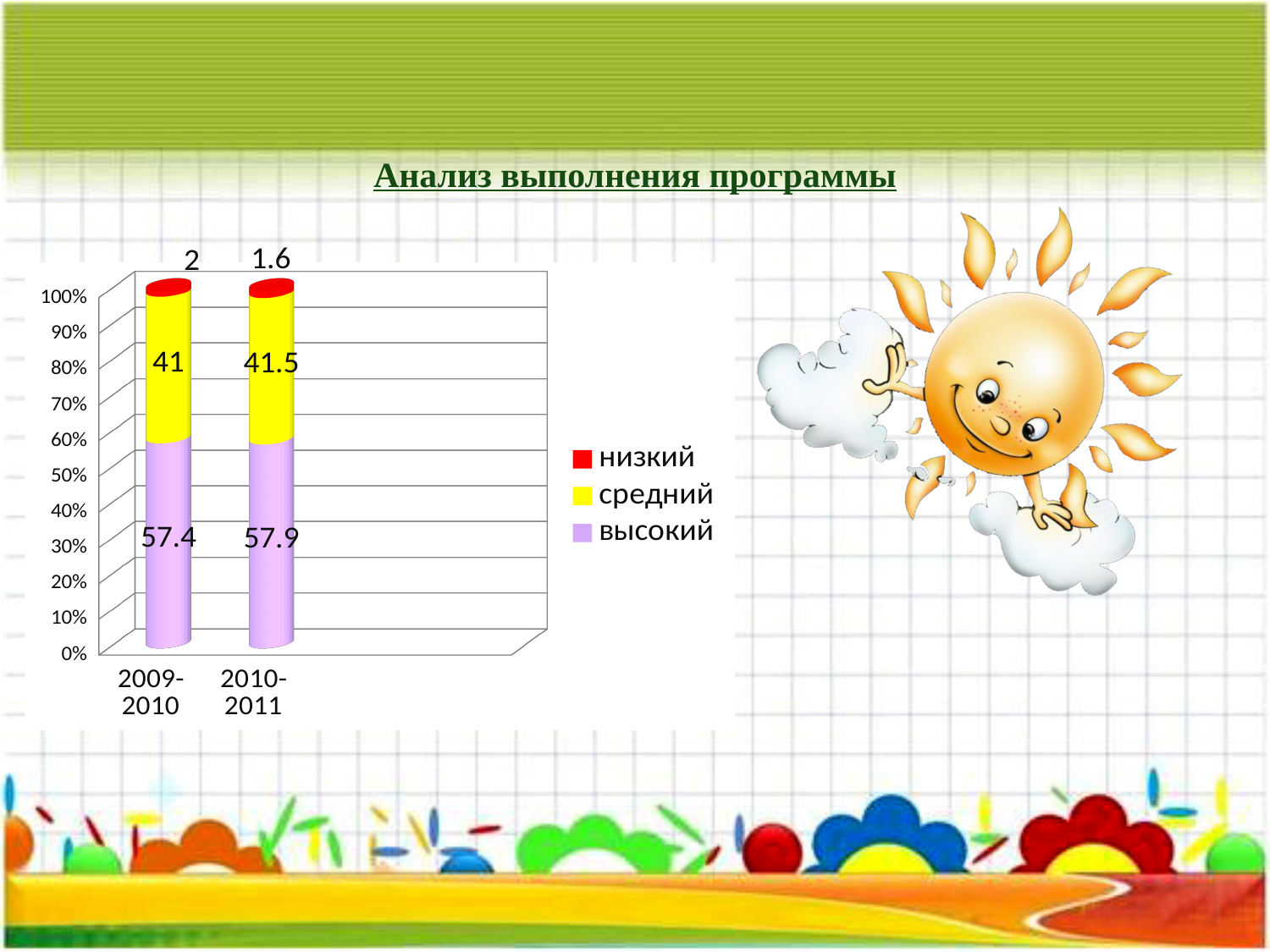
Which year has the larger низкий value, 2009-2010 or 2010-2011? 2009-2010 What is the value of the средний series for 2009-2010? 41 What is the value of the низкий series for 2009-2010? 2 What is the value of the высокий series for 2009-2010? 57.4 How many categories are shown on the x axis? 2 How many series does the legend list? 3 What is the difference between the высокий values for 2010-2011 and 2009-2010? 0.5 What kind of chart is shown on the slide? stacked bar chart Which series has the smallest value for 2009-2010? низкий Which series has the largest value for 2010-2011? высокий What is the value of the низкий series for 2010-2011? 1.6 What is the value of the средний series for 2010-2011? 41.5